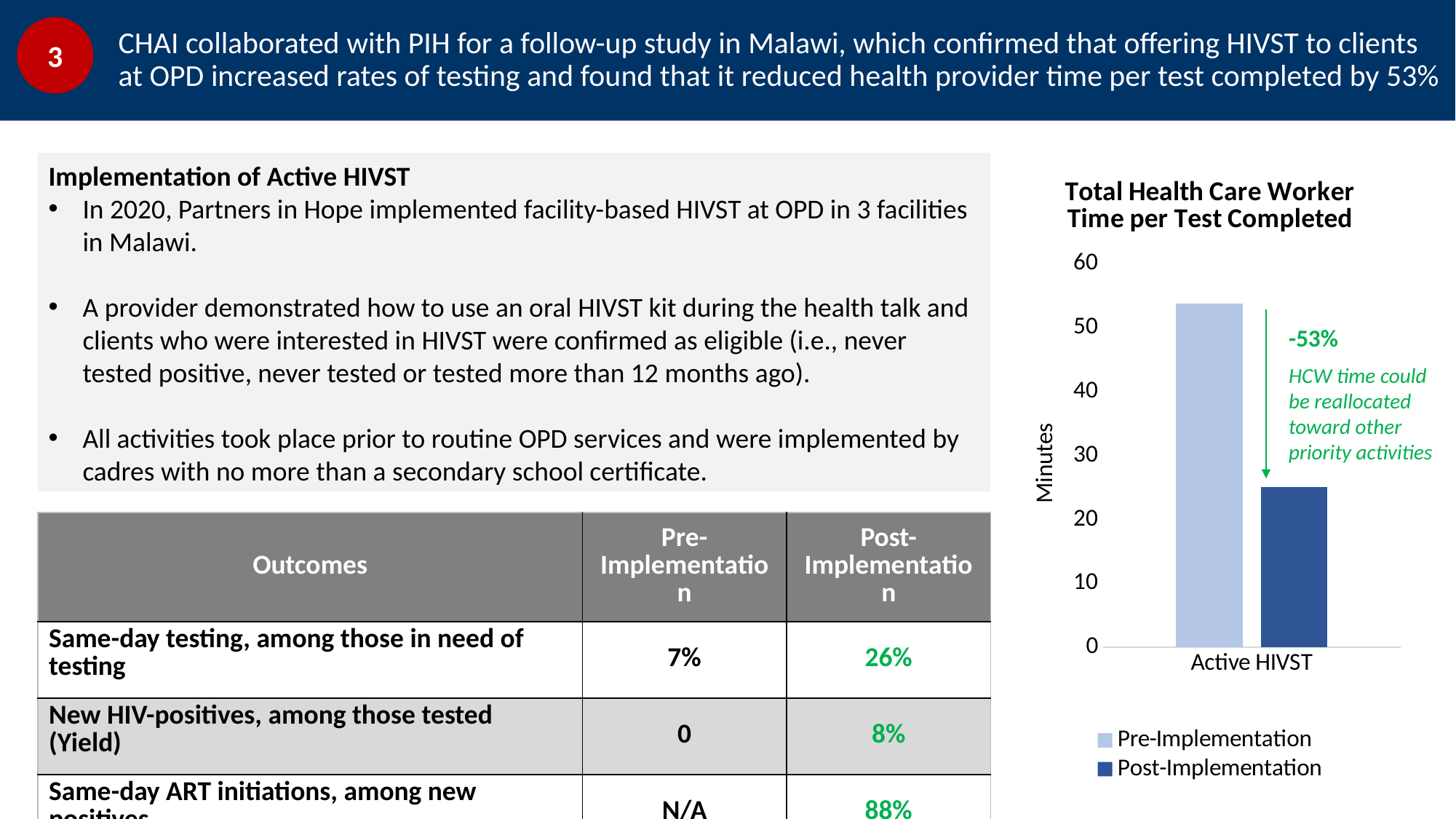
How many categories are shown on the x axis of the chart? 1 What is the title of the chart? Total Health Care Worker Time per Test Completed Is the Post-Implementation value for Active HIVST greater or less than 20? greater What percentage change is annotated between the two bars in the chart? -53% Is the Post-Implementation value for Active HIVST greater or less than 30? less How many series does the legend of the chart list? 2 Which is larger for Active HIVST, the Pre-Implementation value or the Post-Implementation value? Pre-Implementation What kind of chart is shown on the slide? bar chart Is the Pre-Implementation value for Active HIVST greater or less than 50? greater What is the label of the category on the x axis of the chart? Active HIVST